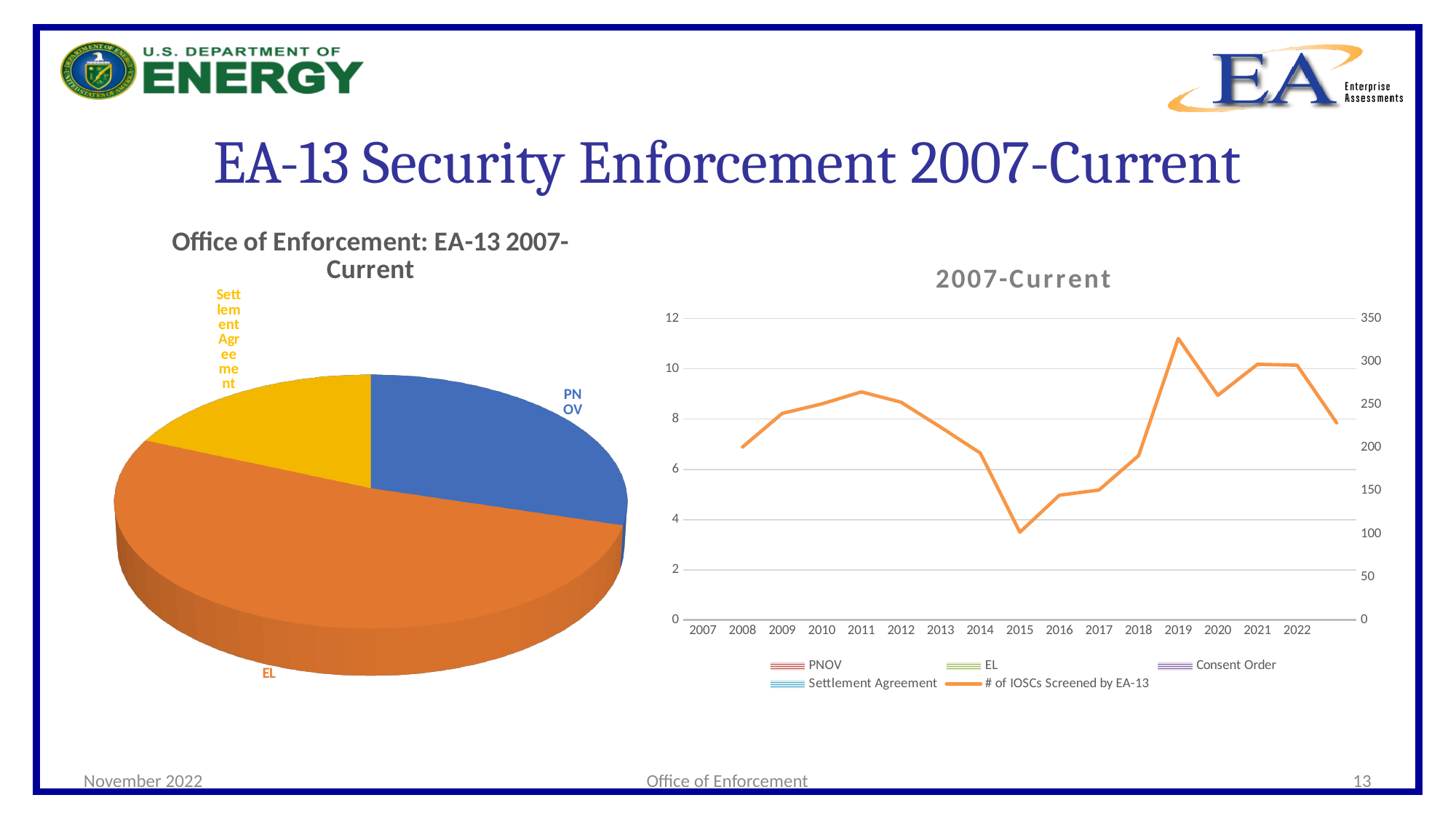
In the pie chart "Office of Enforcement: EA-13 2007-Current", which category has the largest slice? EL In the "2007-Current" line chart, in which year does the # of IOSCs Screened by EA-13 line reach its highest point? 2019 In the "2007-Current" line chart, is the # of IOSCs Screened by EA-13 value for 2019 greater or less than 300 on the right-hand axis? greater How many series does the legend of the "2007-Current" line chart list? 5 How many slices does the pie chart "Office of Enforcement: EA-13 2007-Current" have? 3 In the pie chart "Office of Enforcement: EA-13 2007-Current", which category has the smallest slice? Settlement Agreement In the "2007-Current" line chart, does the # of IOSCs Screened by EA-13 line rise or fall between 2015 and 2019? Rise In the "2007-Current" line chart, is the # of IOSCs Screened by EA-13 value for 2015 greater or less than 150 on the right-hand axis? less In the "2007-Current" line chart, in which year does the # of IOSCs Screened by EA-13 line reach its lowest point? 2015 What kind of chart is the chart titled "2007-Current"? Line chart What kind of chart is the chart titled "Office of Enforcement: EA-13 2007-Current"? Pie chart In the pie chart "Office of Enforcement: EA-13 2007-Current", which slice is larger, PNOV or Settlement Agreement? PNOV